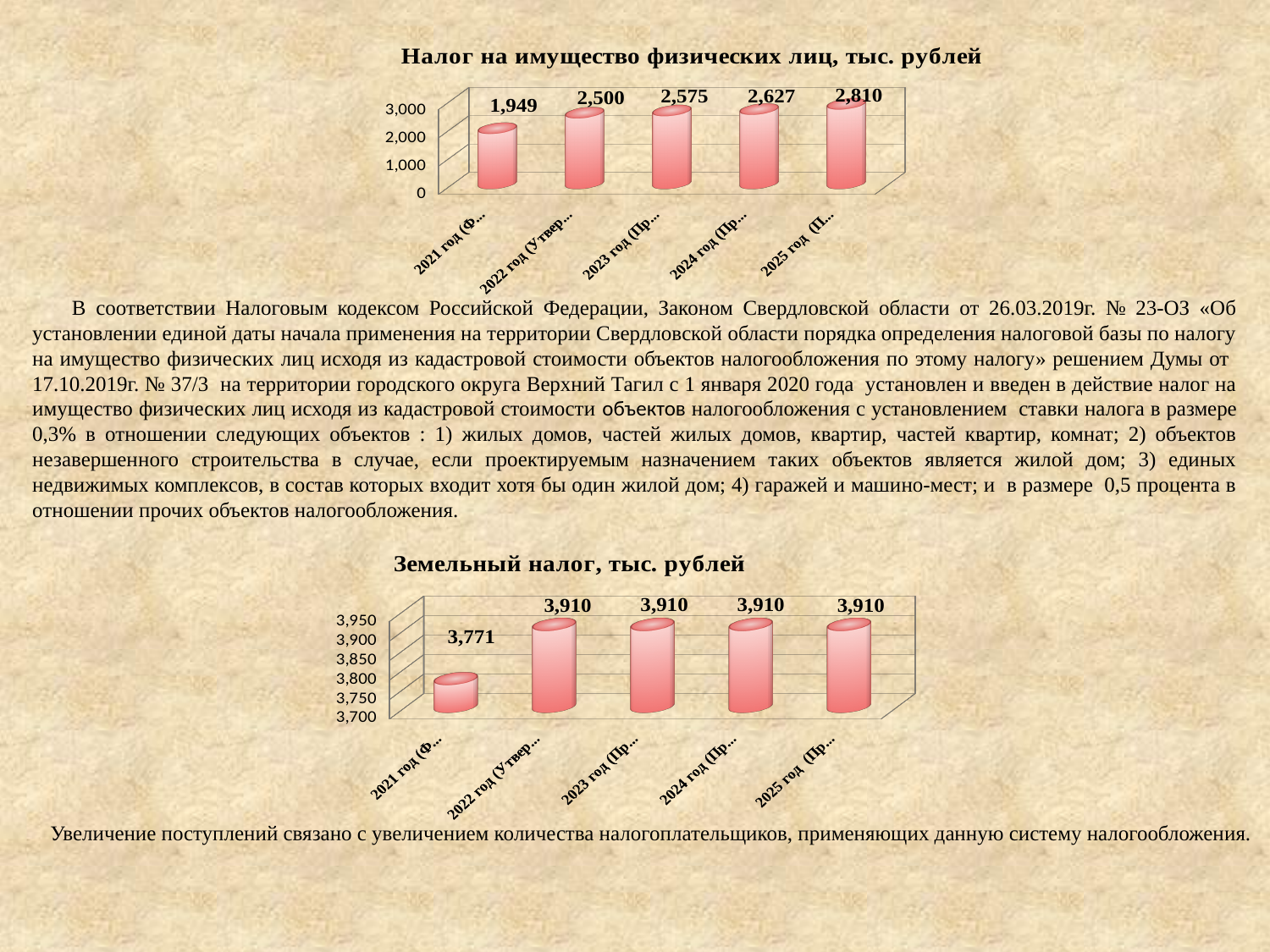
In the chart titled "Налог на имущество физических лиц, тыс. рублей", what is the value for 2021? 1,949 In the chart titled "Земельный налог, тыс. рублей", what is the difference between the 2022 and 2021 values? 139 In the chart titled "Земельный налог, тыс. рублей", what is the value for 2021? 3,771 In the chart titled "Налог на имущество физических лиц, тыс. рублей", how many bars are plotted? 5 In the chart titled "Земельный налог, тыс. рублей", which is larger, the value for 2021 or the value for 2023? 2023 What kind of chart is the one titled "Налог на имущество физических лиц, тыс. рублей"? bar chart In the chart titled "Налог на имущество физических лиц, тыс. рублей", what is the value for 2025? 2,810 In the chart titled "Налог на имущество физических лиц, тыс. рублей", which year has the lowest value? 2021 In the chart titled "Налог на имущество физических лиц, тыс. рублей", do the values rise or fall from 2021 to 2025? rise In the chart titled "Земельный налог, тыс. рублей", is the value for 2021 greater or less than 3,800? less In the chart titled "Налог на имущество физических лиц, тыс. рублей", what is the difference between the 2025 and 2021 values? 861 In the chart titled "Земельный налог, тыс. рублей", what is the value for 2024? 3,910